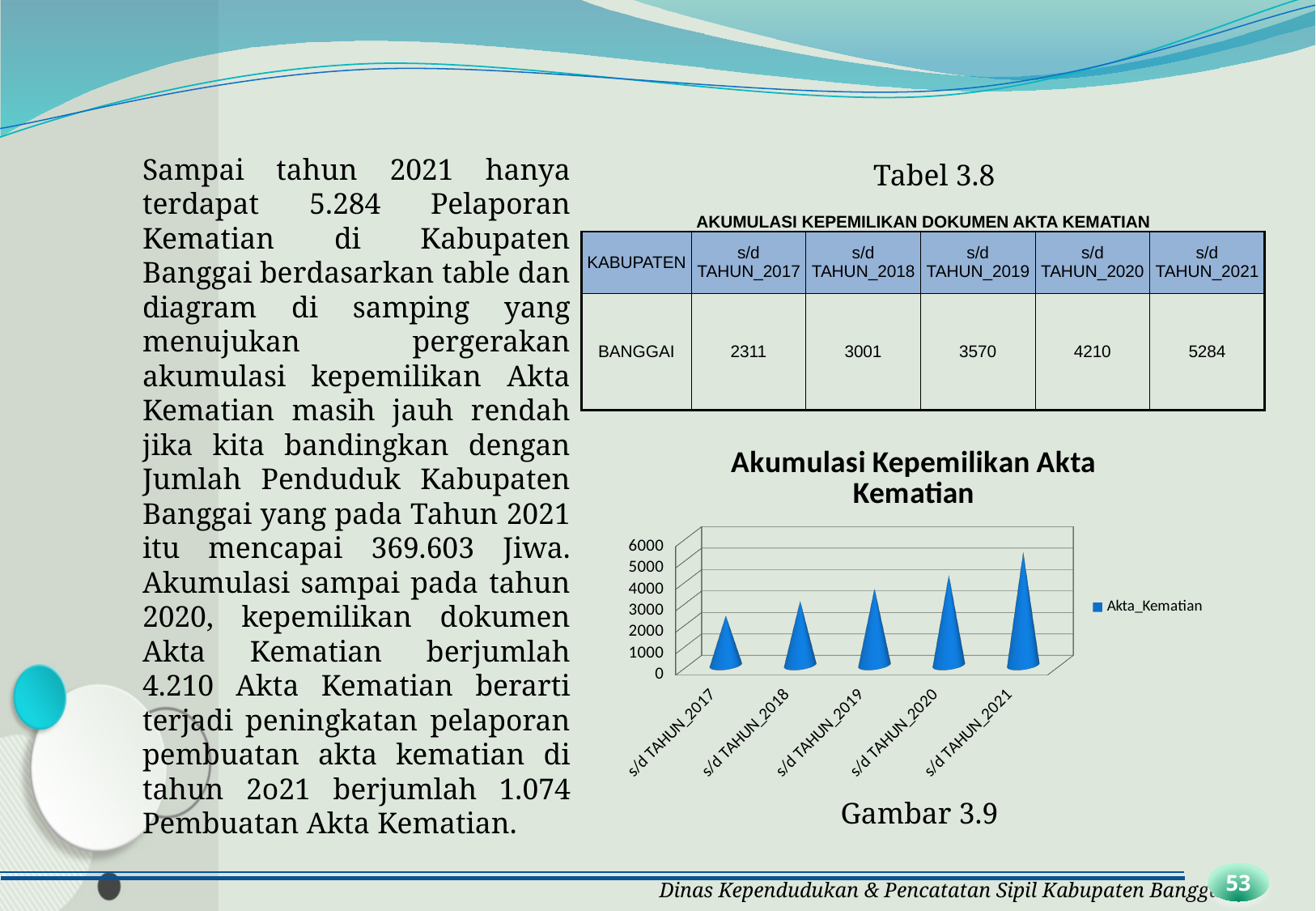
In the "Akumulasi Kepemilikan Akta Kematian" chart, is the value for s/d TAHUN_2021 greater or less than 5000? greater According to Tabel 3.8, what is the difference between the values for s/d TAHUN_2021 and s/d TAHUN_2020? 1074 In the "Akumulasi Kepemilikan Akta Kematian" chart, which is larger, the value for s/d TAHUN_2019 or s/d TAHUN_2020? s/d TAHUN_2020 What is the name of the series shown in the legend of the "Akumulasi Kepemilikan Akta Kematian" chart? Akta_Kematian How many categories are plotted along the x axis of the "Akumulasi Kepemilikan Akta Kematian" chart? 5 Which category has the lowest value in the "Akumulasi Kepemilikan Akta Kematian" chart? s/d TAHUN_2017 Do the values in the "Akumulasi Kepemilikan Akta Kematian" chart rise or fall from s/d TAHUN_2017 to s/d TAHUN_2021? rise In the "Akumulasi Kepemilikan Akta Kematian" chart, is the value for s/d TAHUN_2017 greater or less than 3000? less How many series does the legend of the "Akumulasi Kepemilikan Akta Kematian" chart list? 1 Which category has the highest value in the "Akumulasi Kepemilikan Akta Kematian" chart? s/d TAHUN_2021 According to Tabel 3.8, what is the value for BANGGAI for s/d TAHUN_2021? 5284 What type of chart is shown under the title "Akumulasi Kepemilikan Akta Kematian"? bar chart